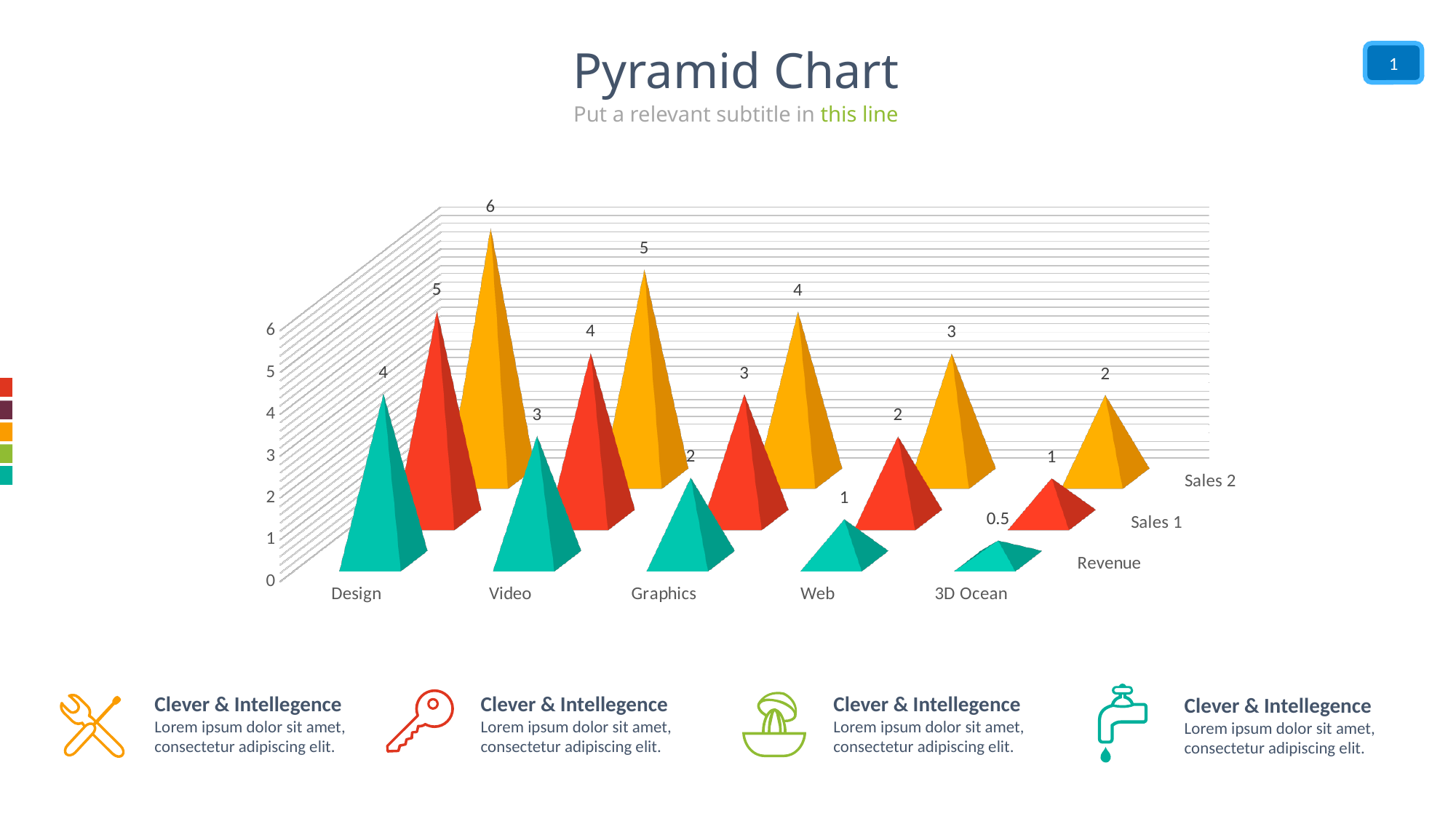
What is the title of the slide containing the chart? Pyramid Chart What is the Sales 2 value for Video? 5 What is the Sales 1 value for Web? 2 Which is larger for Video: the Sales 1 value or the Revenue value? Sales 1 What is the Revenue value for Design? 4 What is the difference between the Sales 2 value and the Revenue value for Graphics? 2 How many categories are shown on the x axis? 5 Do the Sales 1 values rise or fall from Design to 3D Ocean? fall Which category has the lowest Revenue value? 3D Ocean Which category has the highest Sales 2 value? Design How many data series are plotted in the chart? 3 What is the Revenue value for 3D Ocean? 0.5